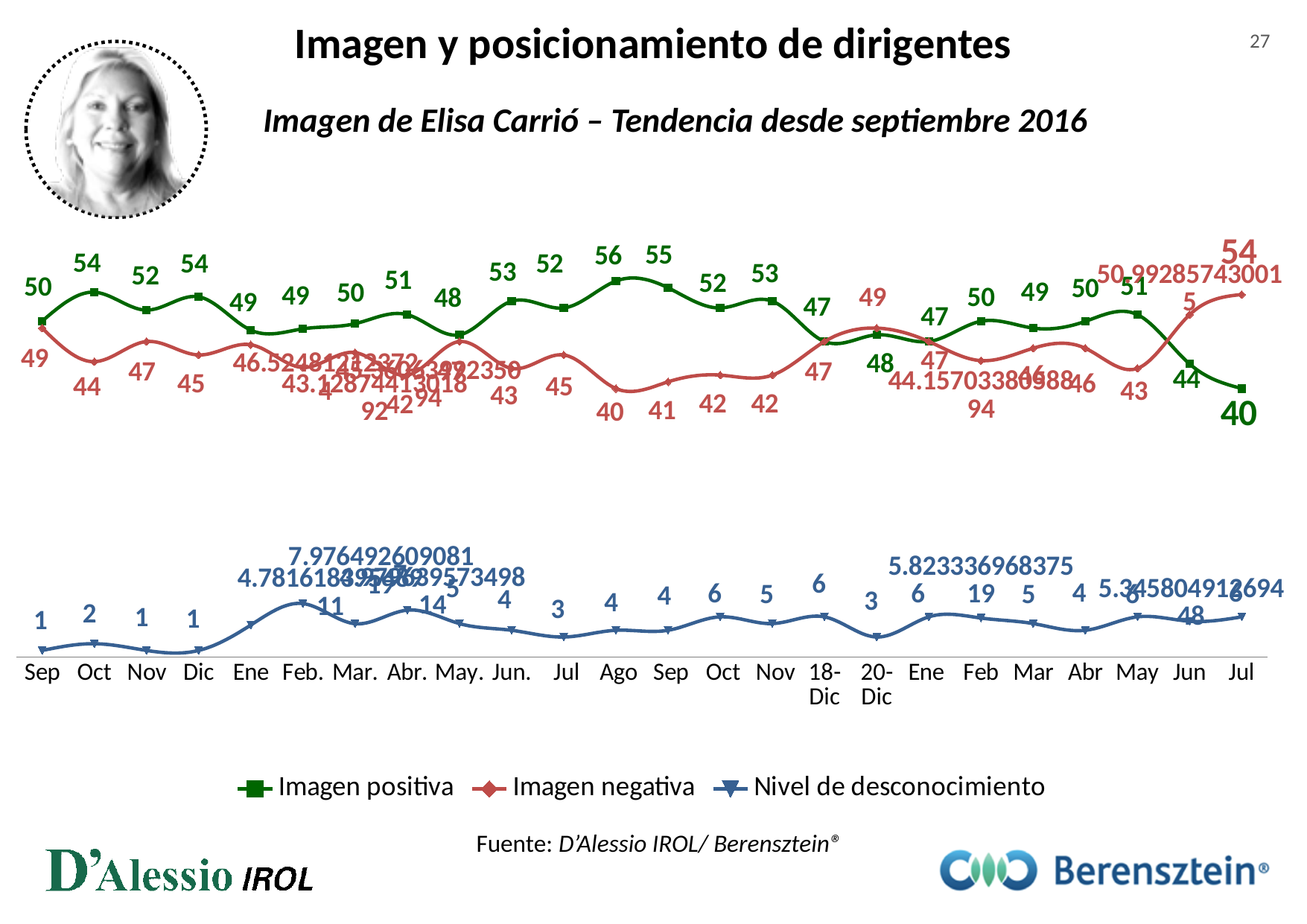
What is the Imagen positiva value at the last point, Jul? 40 Does Imagen positiva rise or fall from May to the last Jul? fall What is the Nivel de desconocimiento value at the first point, Sep? 1 At which point does Imagen positiva reach its lowest value? Jul (last point) What is the Imagen negativa value at the last point, Jul? 54 How many series does the legend list? 3 How many points are plotted along the x axis for each series? 24 At which month does Imagen positiva reach its highest value? Ago What is the Imagen positiva value at Ago? 56 At Ago, which is larger: Imagen positiva or Imagen negativa? Imagen positiva What kind of chart is shown on the slide? line chart What is the difference between the Imagen positiva value at Ago and at the last Jul? 16